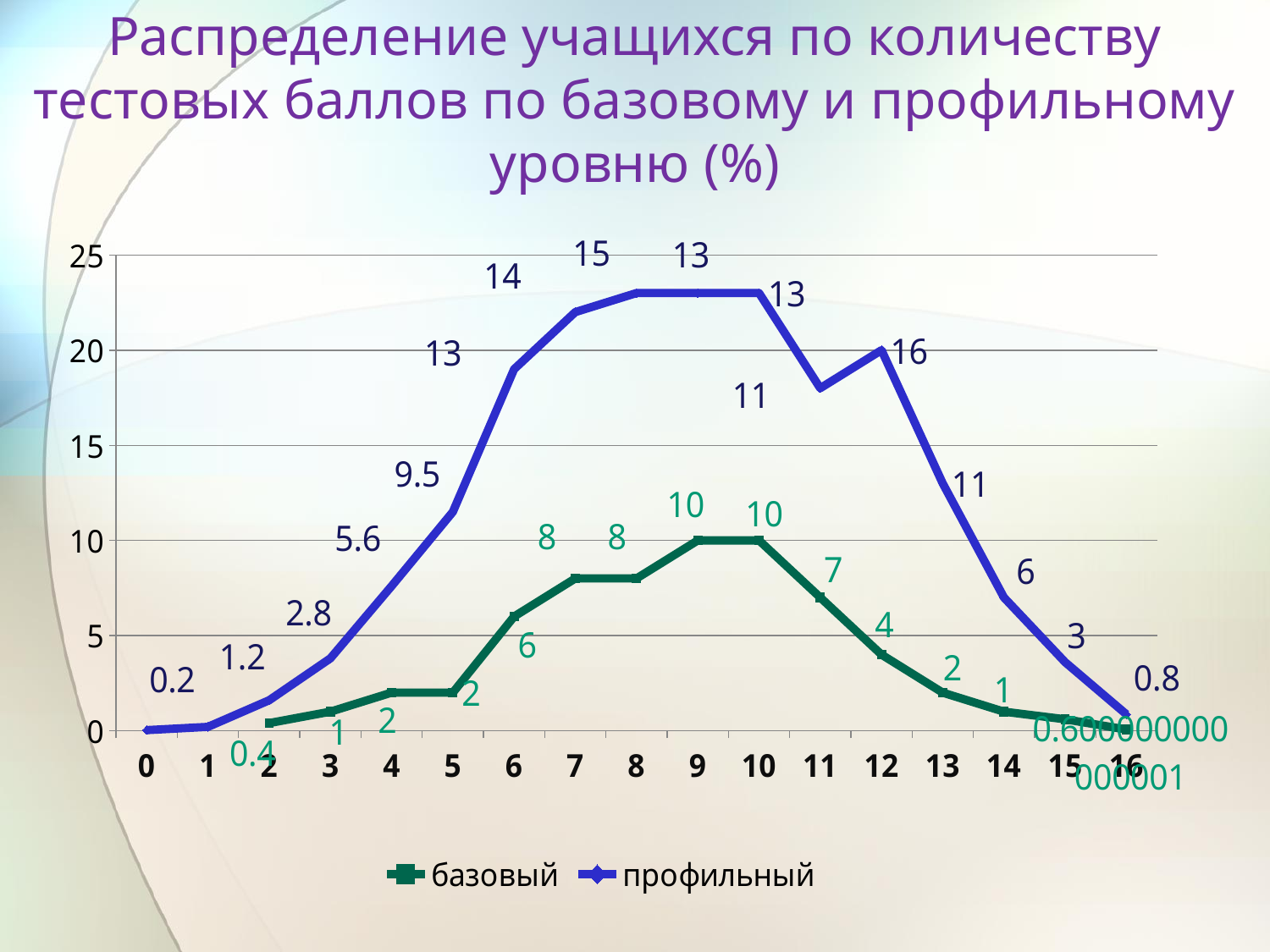
How many series does the legend list? 2 What is the value of the базовый series at score 6? 6 What kind of chart is shown on the slide? line chart What are the names of the two series in the legend? базовый, профильный What is the difference between the базовый values at score 9 and score 11? 3 Is the value of the профильный series at score 8 greater or less than 20? less At score 9, which series has the larger value, базовый or профильный? профильный How many x-axis categories (score values) are plotted? 17 What is the value of the базовый series at score 11? 7 Does the базовый series rise or fall from score 10 to score 14? fall What is the value of the базовый series at score 9? 10 What is the difference between the базовый values at score 7 and score 12? 4